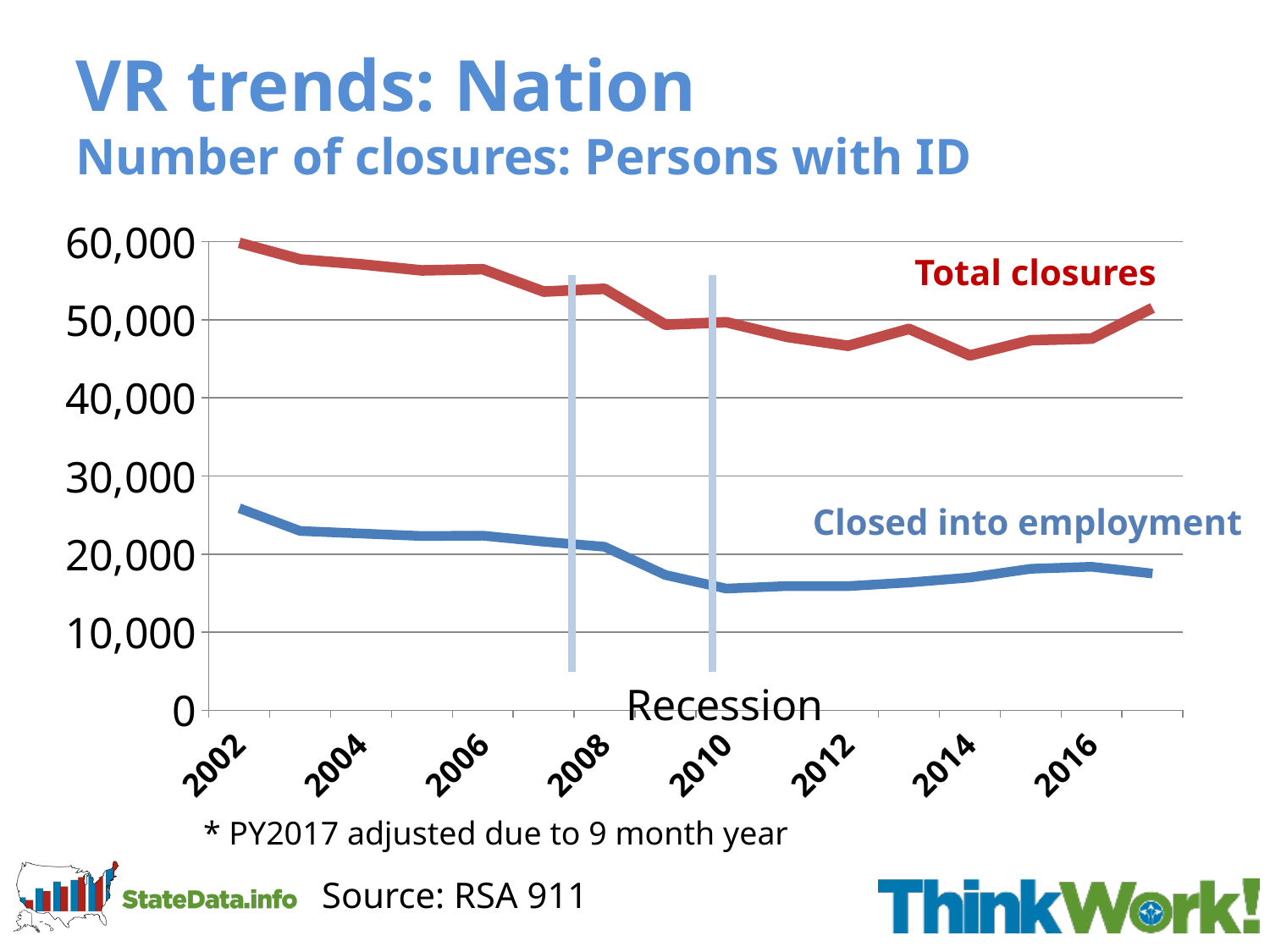
How many data series are plotted on the chart? 2 Which series has higher values throughout the chart, Total closures or Closed into employment? Total closures Is the value for Closed into employment in 2010 greater or less than 20,000? less In which year is Total closures at its highest? 2002 Is the value for Total closures in 2002 greater or less than 50,000? greater What kind of chart is shown on the slide? line chart Does the Total closures line generally rise or fall from 2002 to 2014? fall In which year is Total closures at its lowest? 2014 Is the value for Closed into employment in 2002 greater or less than 20,000? greater What period do the two vertical shaded bands on the chart mark? Recession What colour is the Total closures line? red